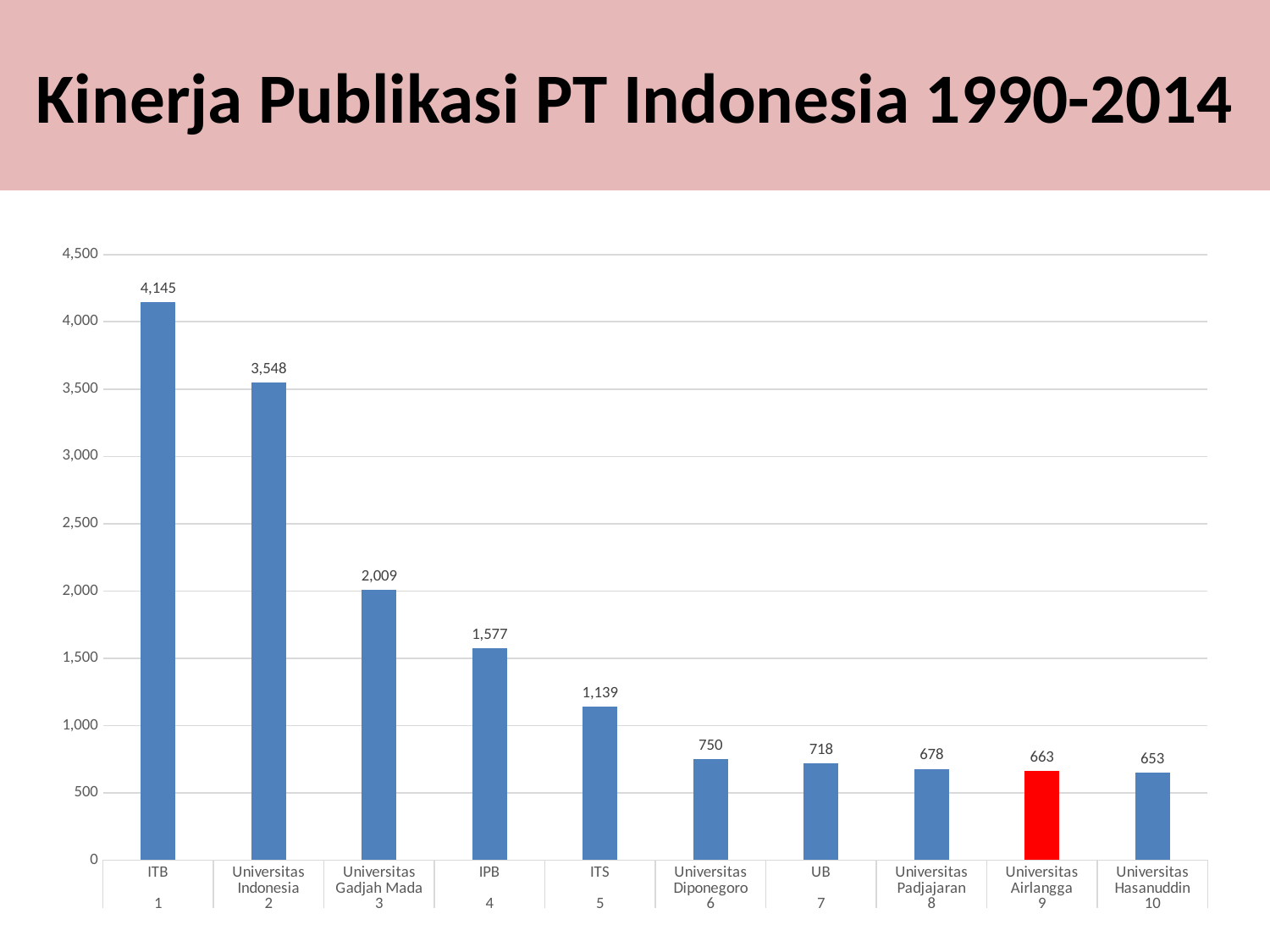
Is the value for Universitas Padjajaran greater or less than 500? greater How many universities are shown on the chart? 10 Which university has the lowest value? Universitas Hasanuddin What is the difference between the values for IPB and ITS? 438 What is the difference between the values for ITB and Universitas Indonesia? 597 What is the value for ITB? 4,145 What is the value for Universitas Airlangga? 663 What is the value for Universitas Gadjah Mada? 2,009 Which bar is coloured red? Universitas Airlangga What kind of chart is shown on the slide? bar chart Which is larger, the value for Universitas Diponegoro or the value for UB? Universitas Diponegoro Which university has the highest value? ITB